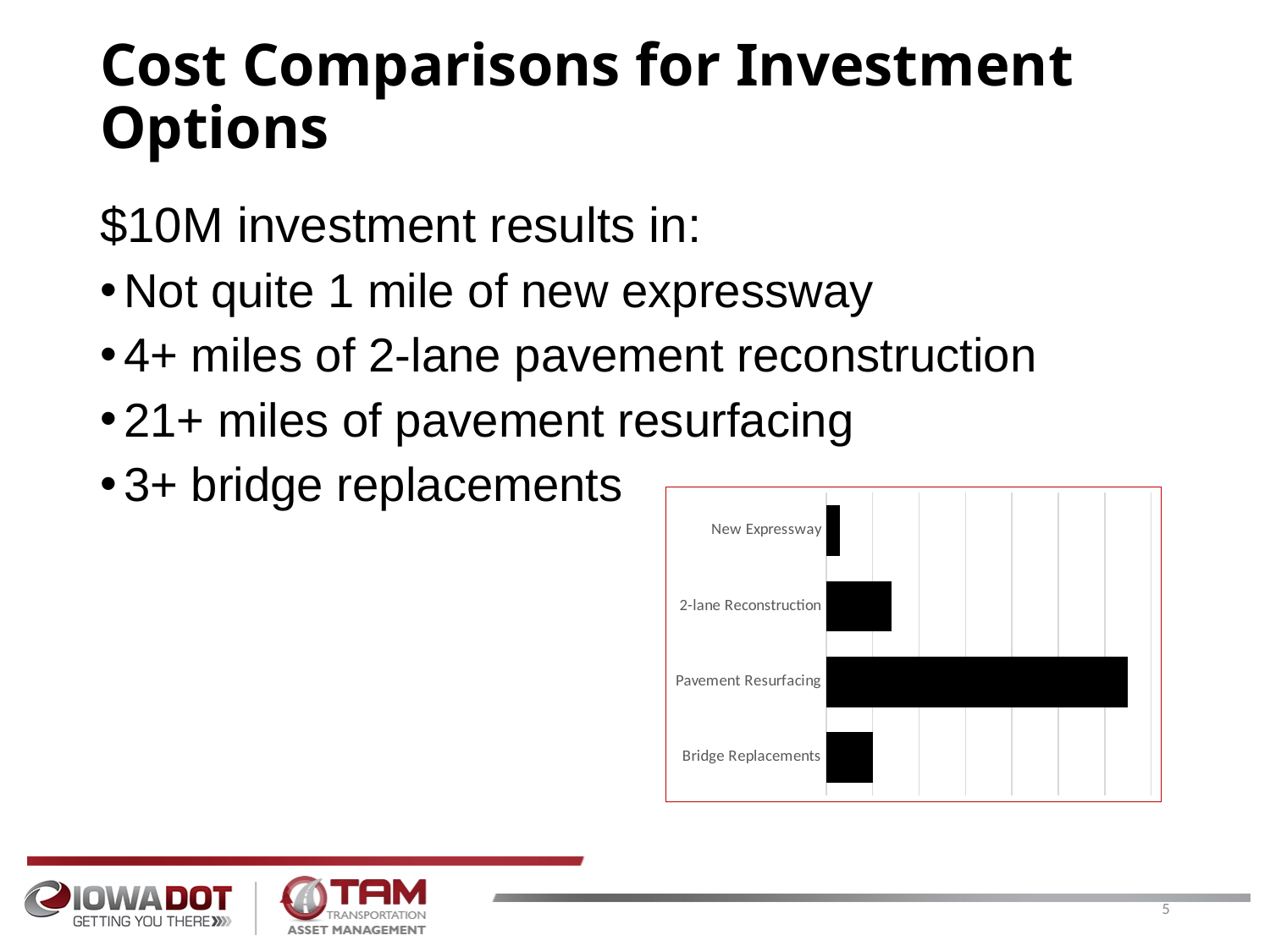
Which category is listed at the top of the chart? New Expressway Which category has the longest bar in the chart? Pavement Resurfacing How many categories does the bar chart show? 4 Which bar is longer, New Expressway or 2-lane Reconstruction? 2-lane Reconstruction What kind of chart is shown on the slide? bar chart Which bar is longer, Pavement Resurfacing or 2-lane Reconstruction? Pavement Resurfacing Which bar is longer, Pavement Resurfacing or Bridge Replacements? Pavement Resurfacing Which category has the shortest bar in the chart? New Expressway What colour are the bars in the chart? black Are the bars in the chart horizontal or vertical? horizontal